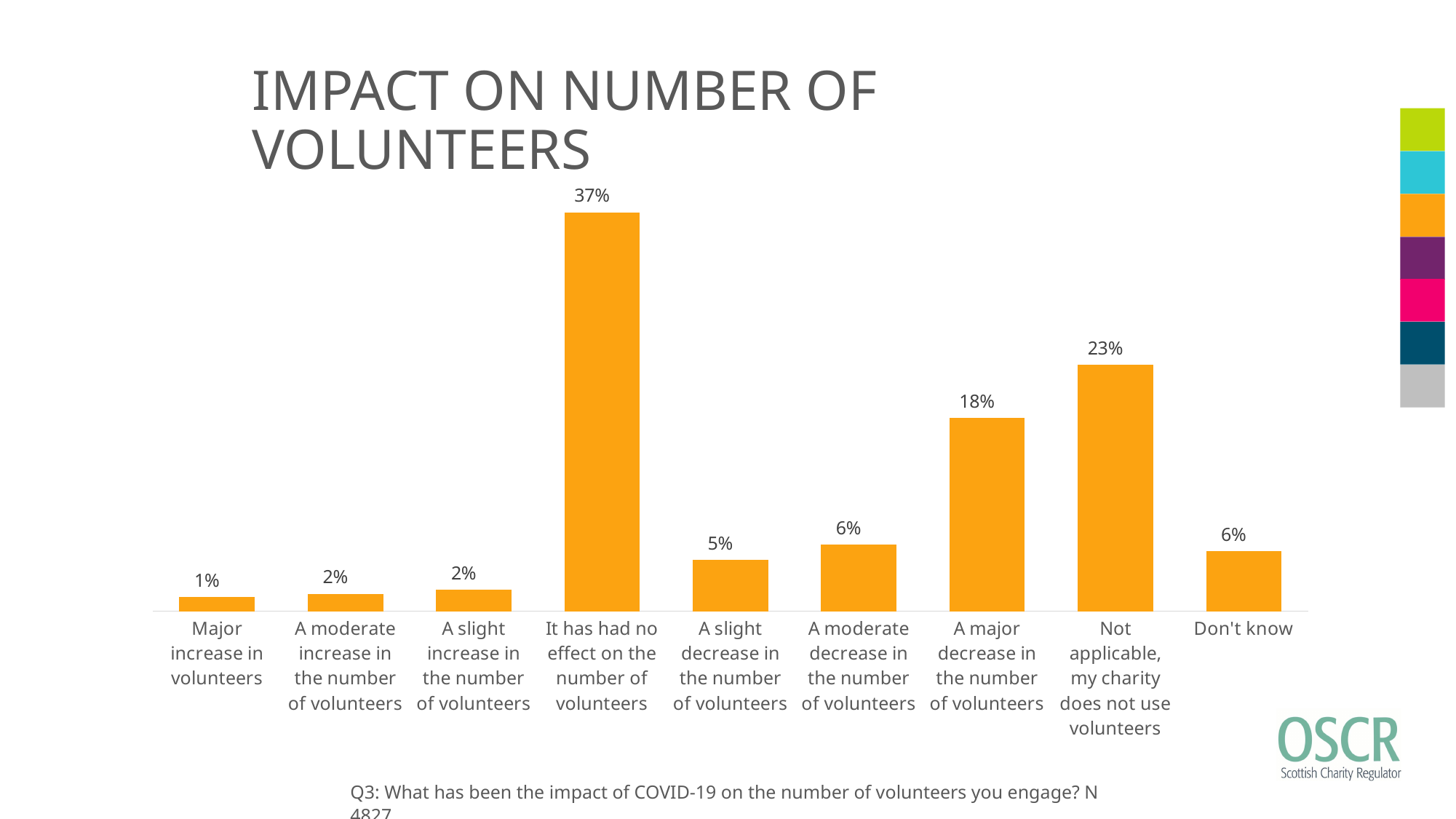
How many categories are shown on the chart? 9 Which category has the highest value? It has had no effect on the number of volunteers What type of chart is shown on the slide? Bar chart What is the value for 'Don't know'? 6% What is the title of the chart? IMPACT ON NUMBER OF VOLUNTEERS What is the difference between 'It has had no effect on the number of volunteers' and 'Not applicable, my charity does not use volunteers'? 14% Which is larger: 'A moderate decrease in the number of volunteers' or 'A slight decrease in the number of volunteers'? A moderate decrease in the number of volunteers What percentage of respondents said COVID-19 has had no effect on the number of volunteers? 37% What percentage reported a major decrease in the number of volunteers? 18% Which category has the lowest value? Major increase in volunteers What is the difference between 'A major decrease in the number of volunteers' and 'A slight decrease in the number of volunteers'? 13% What is the value for 'Not applicable, my charity does not use volunteers'? 23%